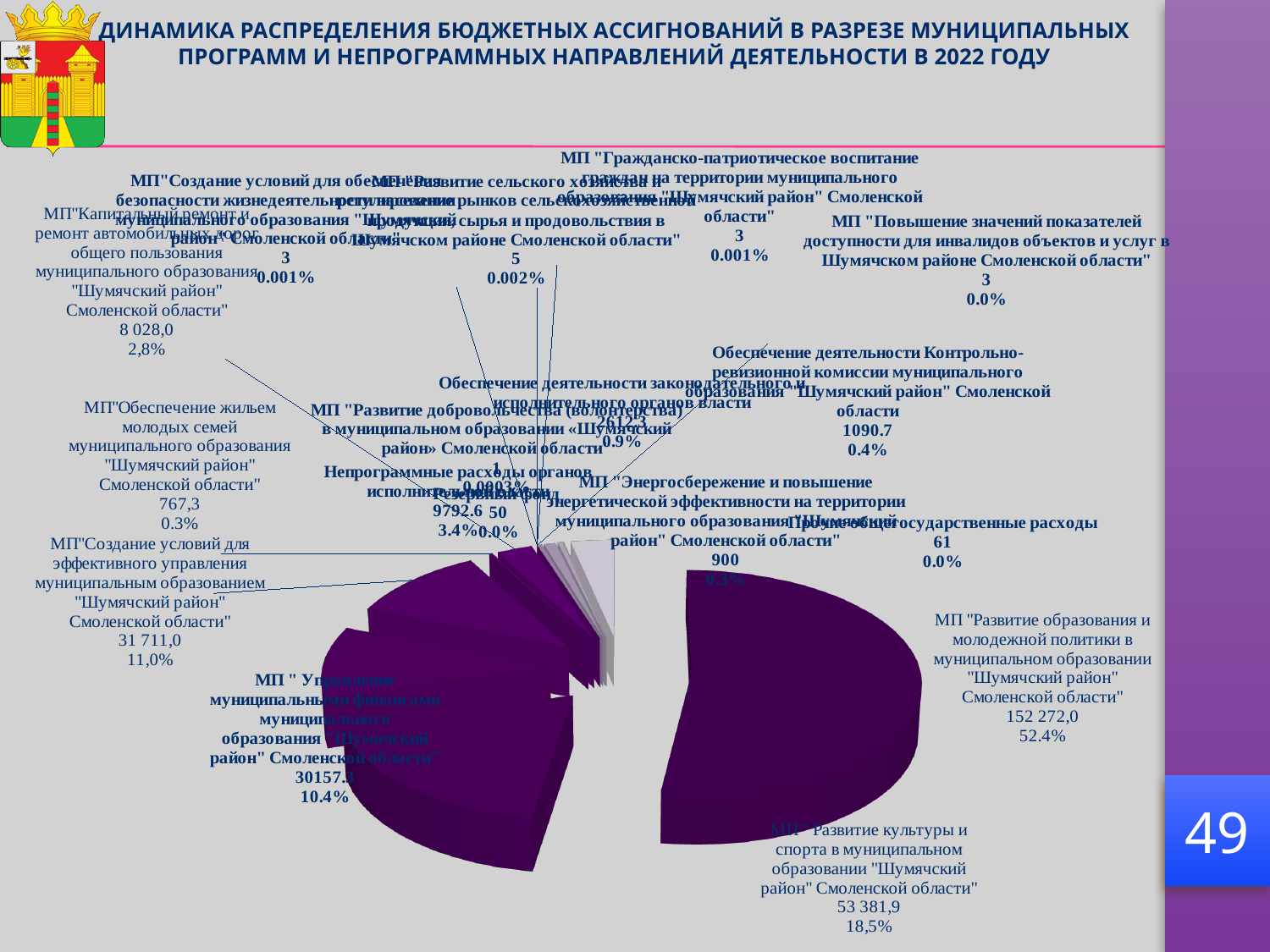
Which is larger: the value for МП "Развитие культуры и спорта" or the value for МП "Управление муниципальными финансами"? МП "Развитие культуры и спорта" What is the value for Непрограммные расходы органов исполнительной власти? 9792.6 Which category has the largest slice of the pie? МП "Развитие образования и молодежной политики в муниципальном образовании "Шумячский район" Смоленской области" What is the value for МП "Развитие образования и молодежной политики в муниципальном образовании "Шумячский район" Смоленской области"? 152 272,0 What share of the pie does МП "Развитие образования и молодежной политики" account for? 52.4% What is the value for МП "Развитие культуры и спорта в муниципальном образовании "Шумячский район" Смоленской области"? 53 381,9 What is the value for МП "Создание условий для эффективного управления муниципальным образованием "Шумячский район" Смоленской области"? 31 711,0 What is the difference between the value for МП "Развитие образования и молодежной политики" (152 272,0) and МП "Развитие культуры и спорта" (53 381,9)? 98 890,1 What share of the pie does МП "Развитие культуры и спорта" account for? 18,5% What is the value for МП "Управление муниципальными финансами муниципального образования "Шумячский район" Смоленской области"? 30157.3 What kind of chart is shown on the slide? pie chart What is the value for МП "Обеспечение жильем молодых семей муниципального образования "Шумячский район" Смоленской области"? 767,3